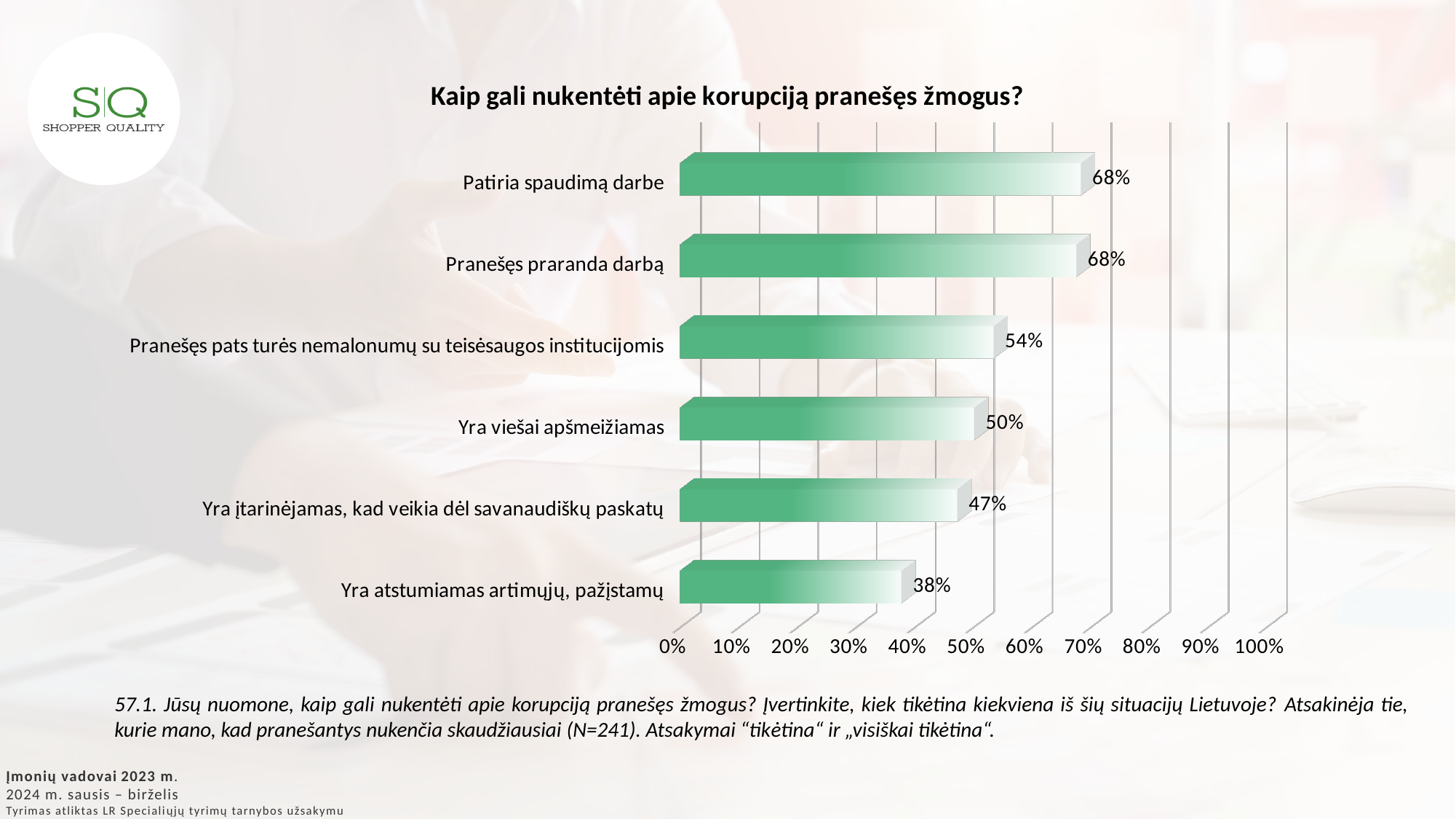
What is the title of the chart? Kaip gali nukentėti apie korupciją pranešęs žmogus? What is the difference between the values for "Pranešęs praranda darbą" and "Yra atstumiamas artimųjų, pažįstamų"? 30% How many categories are shown in the chart? 6 Which is larger: the value for "Yra viešai apšmeižiamas" or the value for "Yra įtarinėjamas, kad veikia dėl savanaudiškų paskatų"? Yra viešai apšmeižiamas Which category has the lowest value? Yra atstumiamas artimųjų, pažįstamų What is the difference between the values for "Pranešęs pats turės nemalonumų su teisėsaugos institucijomis" and "Yra viešai apšmeižiamas"? 4% What is the value for "Yra įtarinėjamas, kad veikia dėl savanaudiškų paskatų"? 47% What is the value for "Yra viešai apšmeižiamas"? 50% What is the value for "Pranešęs pats turės nemalonumų su teisėsaugos institucijomis"? 54% Is the value for "Yra atstumiamas artimųjų, pažįstamų" greater or less than 40%? less What is the value for "Patiria spaudimą darbe"? 68% What kind of chart is shown on the slide? bar chart